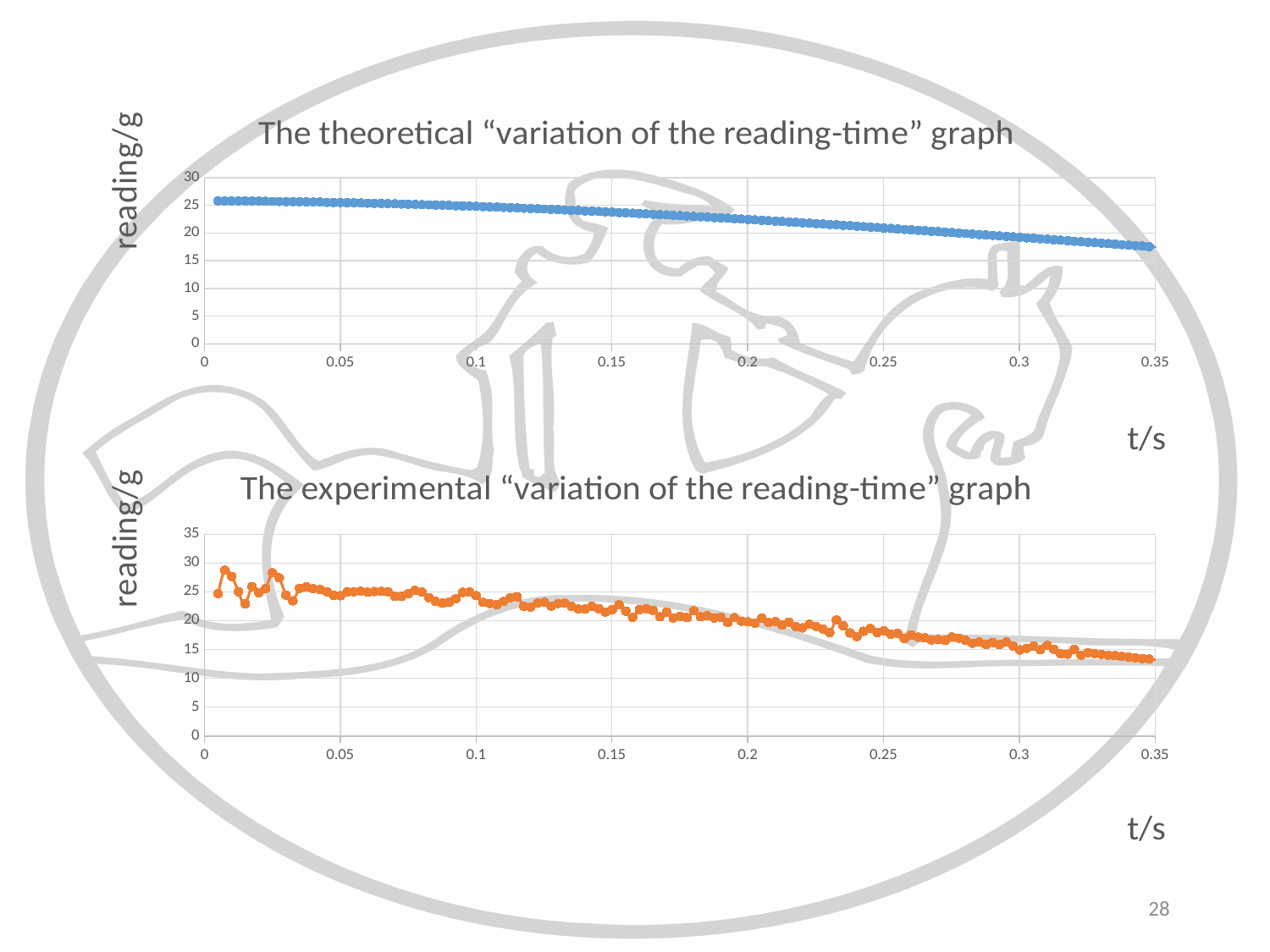
In the top chart (theoretical), is the reading at t = 0.35 s greater or less than 20? less What is the title of the bottom chart? The experimental "variation of the reading-time" graph In the top chart (theoretical), is the reading at t = 0.05 s greater or less than 20? greater In the bottom chart (experimental), is the reading at t = 0.05 s greater or less than 20? greater In the top chart (theoretical), is the reading at t = 0.05 s greater or less than the reading at t = 0.35 s? greater In the bottom chart (experimental), do the values generally rise or fall as t/s increases? fall In the top chart (theoretical), do the values rise or fall as t/s increases? fall What type of chart is the bottom (experimental) chart? line chart What is the highest value shown on the vertical axis of the bottom (experimental) chart? 35 What is the title of the top chart? The theoretical "variation of the reading-time" graph